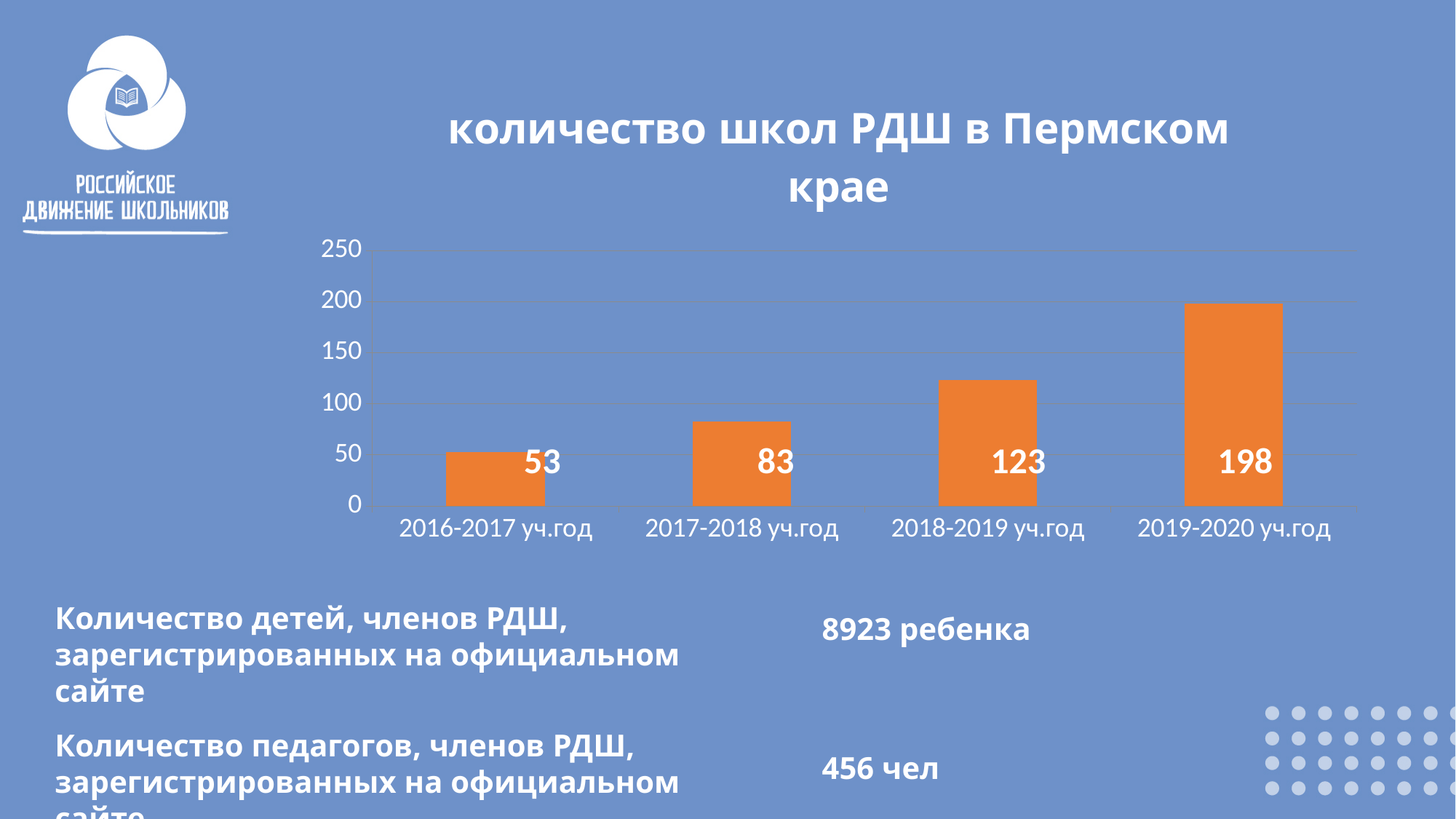
Which academic year has the highest value? 2019-2020 уч.год What is the difference between the values for 2017-2018 уч.год and 2016-2017 уч.год? 30 What is the value for 2018-2019 уч.год? 123 Which academic year has the lowest value? 2016-2017 уч.год Do the values rise or fall from 2016-2017 уч.год to 2019-2020 уч.год? rise What is the value for 2016-2017 уч.год? 53 What is the value for 2019-2020 уч.год? 198 What kind of chart is shown on the slide? bar chart Is the value for 2019-2020 уч.год greater or less than 150? greater How many academic years are shown on the chart? 4 Which is larger, the value for 2017-2018 уч.год or 2018-2019 уч.год? 2018-2019 уч.год What is the difference between the values for 2019-2020 уч.год and 2018-2019 уч.год? 75